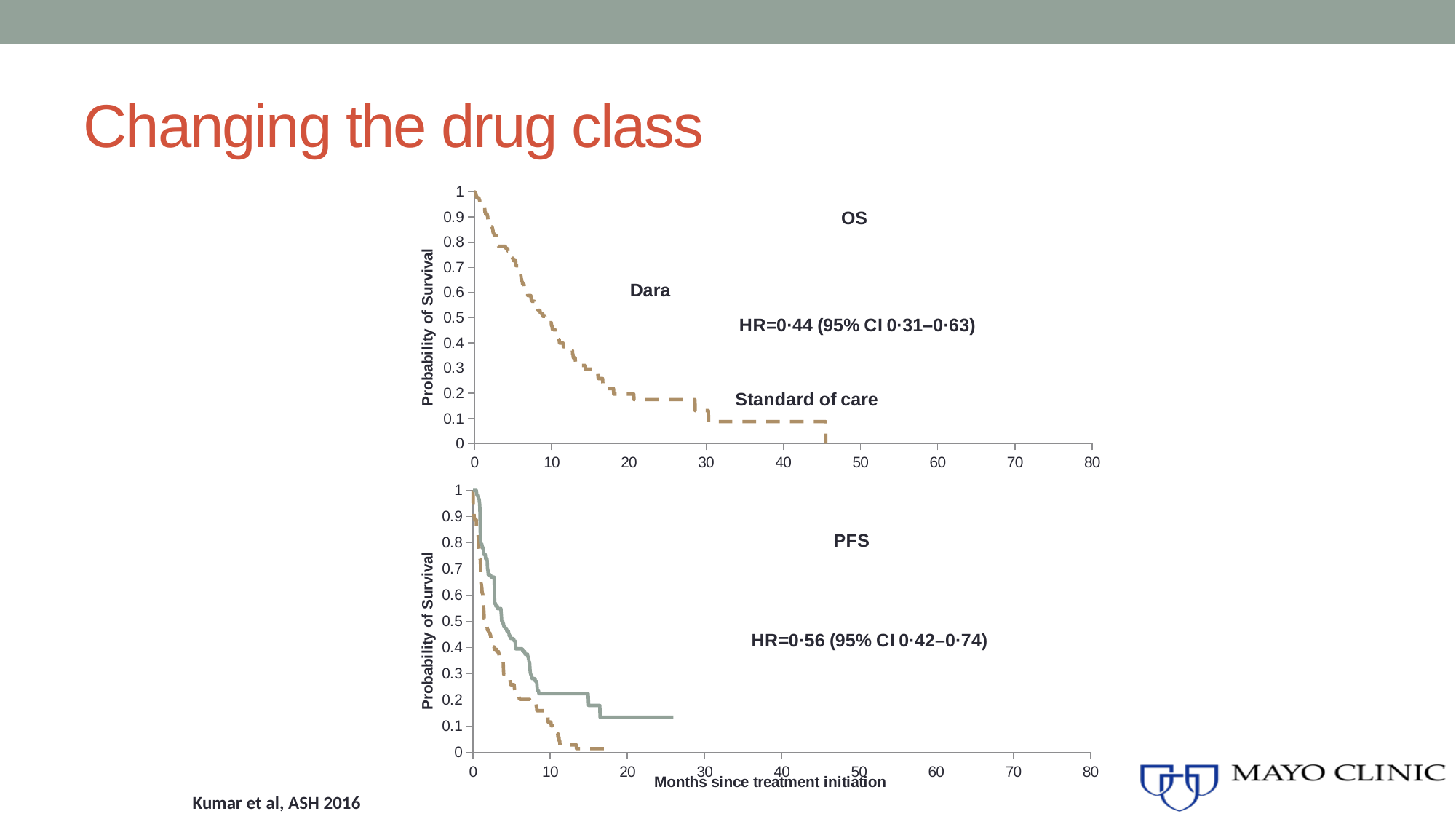
How many charts are shown on the slide? 2 In the top chart (OS), what hazard ratio and confidence interval are printed? HR=0·44 (95% CI 0·31–0·63) In the bottom chart (PFS), do the survival curves rise or fall as months since treatment initiation increase? fall What kind of chart is the top chart labelled OS? line chart In the top chart (OS), is the value of the Standard of care curve at 40 months greater or less than 0.2? less In the bottom chart (PFS), what hazard ratio and confidence interval are printed? HR=0·56 (95% CI 0·42–0·74) In the bottom chart (PFS), is the value of the solid Dara curve at 20 months greater or less than 0.2? less In the bottom chart (PFS), which curve is higher at 10 months, Dara or Standard of care? Dara In the top chart (OS), is the value of the Standard of care curve at 20 months greater or less than 0.3? less In the bottom chart (PFS), what is the probability of survival for both curves at month 0? 1 In the top chart (OS), does the Standard of care curve rise or fall along the x axis? fall